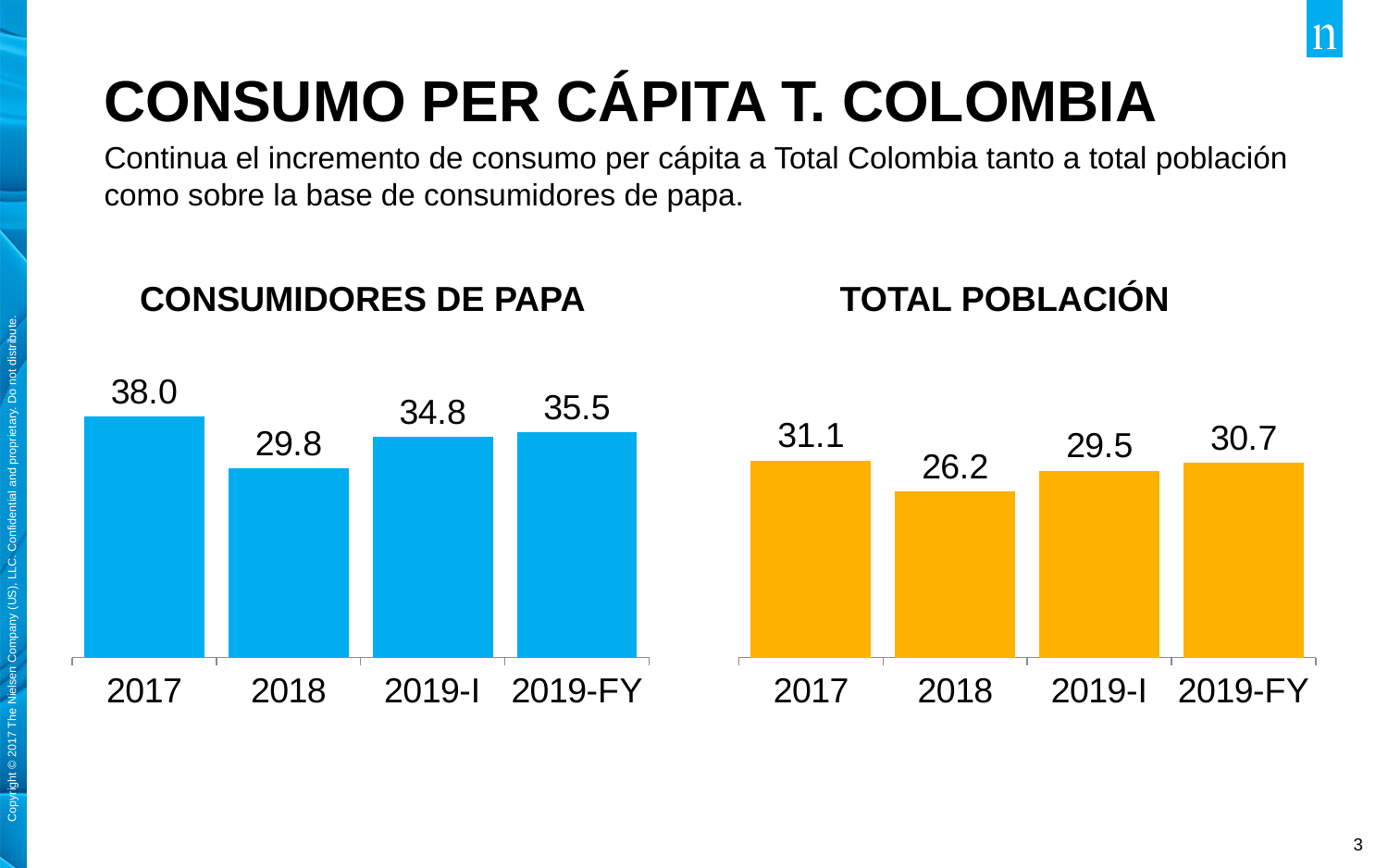
How many categories are shown in the CONSUMIDORES DE PAPA chart? 4 In the TOTAL POBLACIÓN chart, which category has the highest value? 2017 In the CONSUMIDORES DE PAPA chart, do the values rise or fall from 2018 to 2019-FY? Rise In the CONSUMIDORES DE PAPA chart, what is the difference between the 2017 and 2018 values? 8.2 In the CONSUMIDORES DE PAPA chart, which category has the lowest value? 2018 In the TOTAL POBLACIÓN chart, what is the value for 2019-FY? 30.7 In the TOTAL POBLACIÓN chart, what is the difference between the 2019-FY and 2019-I values? 1.2 In the TOTAL POBLACIÓN chart, what is the value for 2018? 26.2 What colour are the bars in the TOTAL POBLACIÓN chart? Orange In the TOTAL POBLACIÓN chart, which is larger, the value for 2018 or the value for 2019-I? 2019-I What kind of chart is the TOTAL POBLACIÓN chart? Bar chart In the CONSUMIDORES DE PAPA chart, what is the value for 2017? 38.0